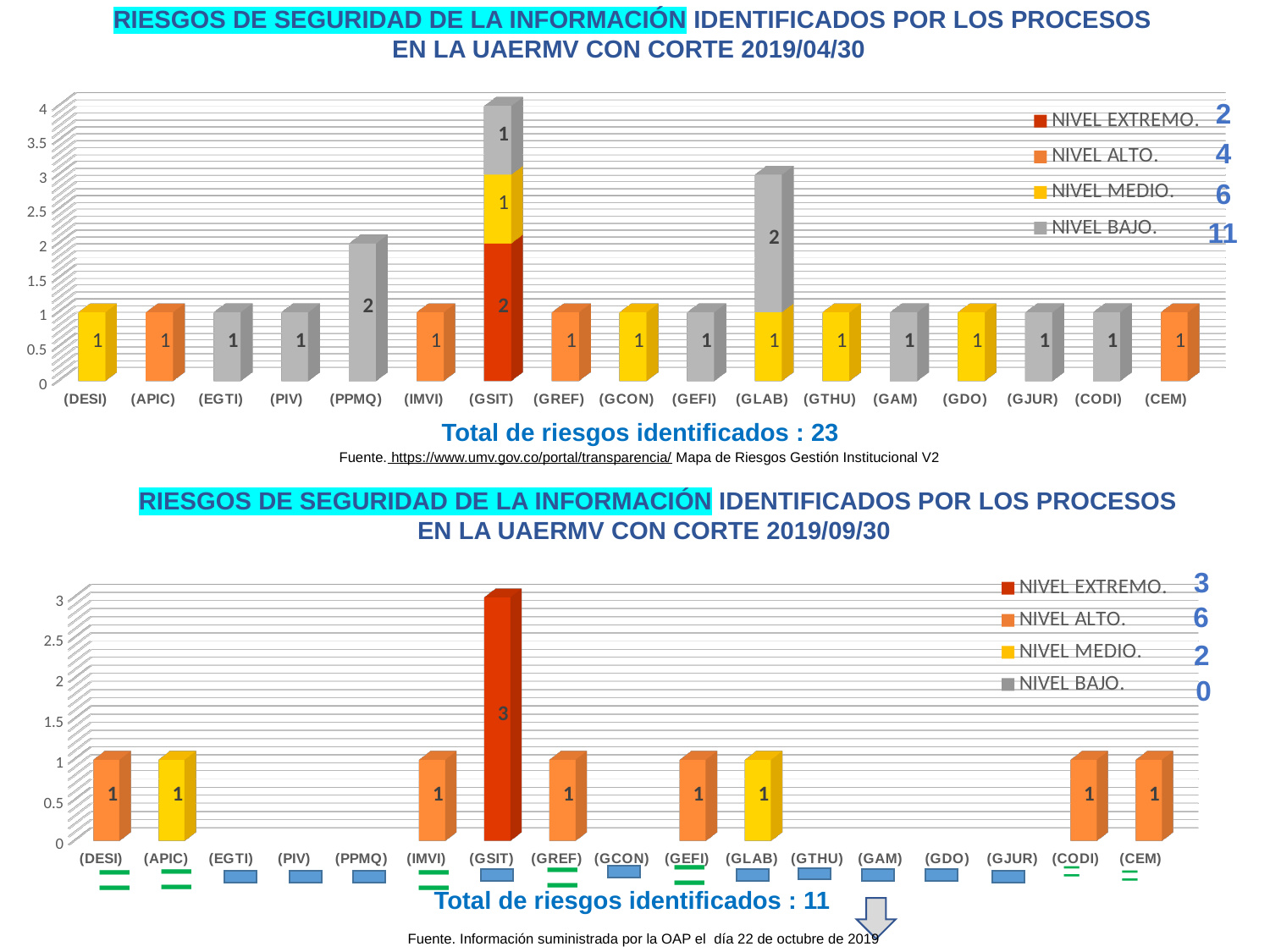
What type of chart is the bottom chart (corte 2019/09/30)? Bar chart In the top chart (corte 2019/04/30), what is the NIVEL BAJO value for (PPMQ)? 2 In the bottom chart (corte 2019/09/30), how many process categories are shown on the x axis? 17 In the top chart (corte 2019/04/30), which process has the tallest stacked bar? (GSIT) In the bottom chart (corte 2019/09/30), which colour represents NIVEL EXTREMO in the legend? Red In the top chart (corte 2019/04/30), what is the total height of the stacked bar for (GLAB)? 3 In the bottom chart (corte 2019/09/30), which process has the highest value? (GSIT) In the bottom chart (corte 2019/09/30), what is the difference between the value for (GSIT) and the value for (CEM)? 2 In the top chart (corte 2019/04/30), what is the total height of the stacked bar for (GSIT)? 4 In the top chart (corte 2019/04/30), what is the NIVEL EXTREMO value for (GSIT)? 2 In the bottom chart (corte 2019/09/30), what is the NIVEL EXTREMO value for (GSIT)? 3 In the top chart (corte 2019/04/30), how many series does the legend list? 4